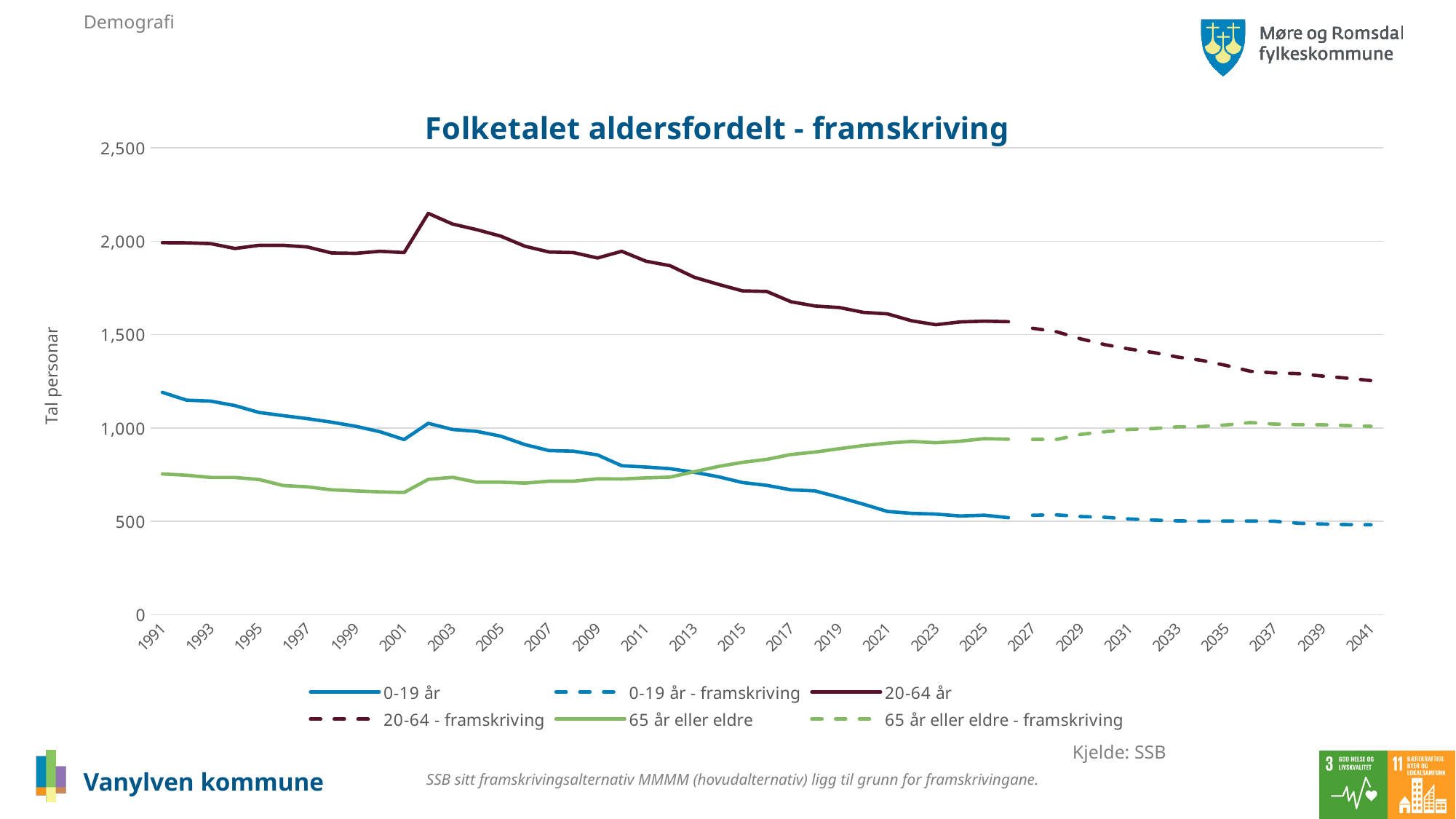
Which series has the highest values across the whole chart? 20-64 år Does the 0-19 år series rise or fall overall from 1991 to 2025? fall In 2021, which is larger: 0-19 år or 65 år eller eldre? 65 år eller eldre What kind of chart is shown on the slide? line chart Does the 65 år eller eldre series rise or fall overall from 1991 to 2025? rise What source is cited below the chart? Kjelde: SSB How many series does the legend list? 6 Does the 20-64 år series rise or fall overall from 1991 to 2025? fall Is the value for 20-64 år in 2002 greater or less than 2,000? greater Is the value for 20-64 - framskriving in 2041 greater or less than 1,500? less What is the title of the chart? Folketalet aldersfordelt - framskriving Is the value for 0-19 år in 1991 greater or less than 1,000? greater